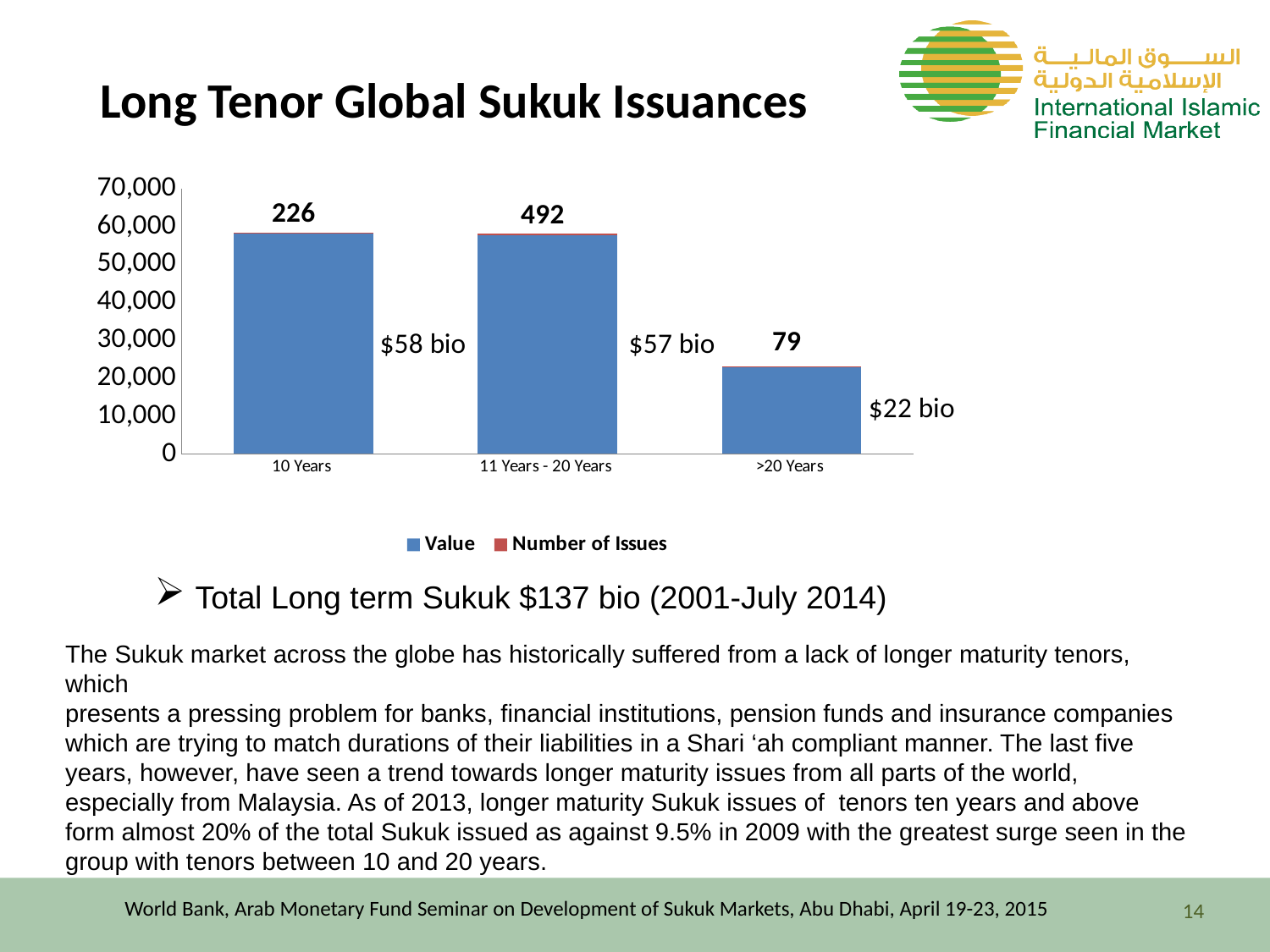
How many series does the chart legend list? 2 Is the Value bar for the 10 Years tenor greater or less than 50,000? greater What value in bio is annotated for the >20 Years tenor? $22 bio What is the title of the chart on the slide? Long Tenor Global Sukuk Issuances Which tenor category has the highest number of issues? 11 Years - 20 Years What are the two series named in the chart legend? Value and Number of Issues Which tenor category has the lowest Value bar? >20 Years What is the number of issues for the 10 Years tenor? 226 How many tenor categories are shown on the x axis of the chart? 3 What is the difference between the number of issues for 11 Years - 20 Years and for 10 Years? 266 What is the number of issues for the 11 Years - 20 Years tenor? 492 What type of chart is shown on the slide? bar chart